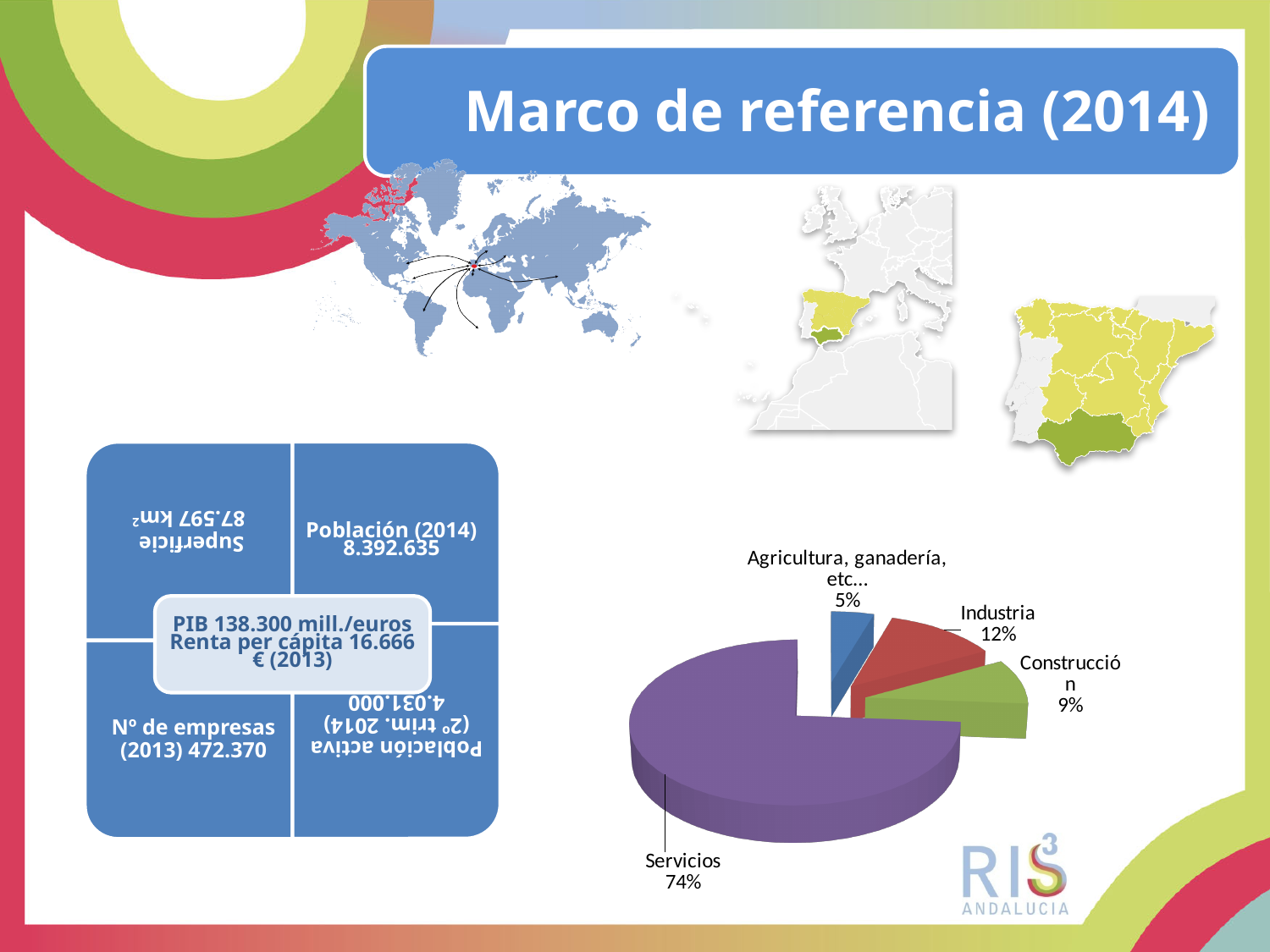
Which is larger in the pie chart, Industria or Construcción? Industria What is the difference in percentage points between Servicios and Industria? 62 How many slices does the pie chart have? 4 What kind of chart is shown on the slide? pie chart What share of the pie does Industria represent? 12% What is the difference in percentage points between Industria and Construcción? 3 Which slice of the pie chart is the largest? Servicios Which slice of the pie chart is the smallest? Agricultura, ganadería, etc... What share of the pie does Construcción represent? 9% What share of the pie does Agricultura, ganadería, etc... represent? 5% What colour is the Servicios slice in the pie chart? purple What share of the pie does Servicios represent? 74%